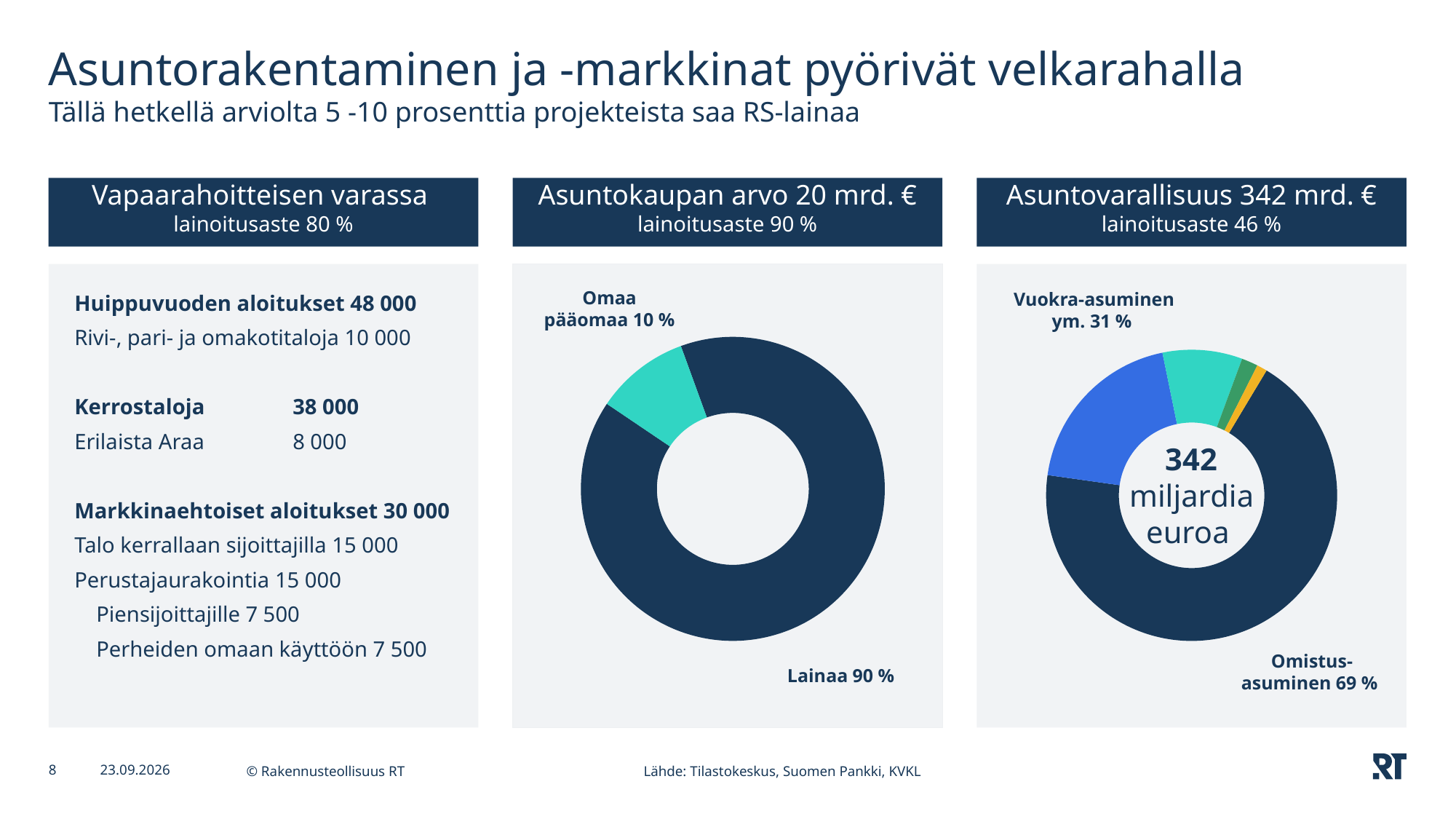
In the chart titled "Asuntokaupan arvo 20 mrd. €", what share is labelled for Omaa pääomaa? 10 % In the chart titled "Asuntovarallisuus 342 mrd. €", what share is labelled for Vuokra-asuminen ym.? 31 % In the chart titled "Asuntokaupan arvo 20 mrd. €", how many labelled categories are there? 2 In the chart titled "Asuntokaupan arvo 20 mrd. €", how many percentage points larger is Lainaa than Omaa pääomaa? 80 percentage points In the chart titled "Asuntovarallisuus 342 mrd. €", which labelled category has the largest share? Omistus-asuminen In the chart titled "Asuntovarallisuus 342 mrd. €", how many percentage points larger is Omistus-asuminen than Vuokra-asuminen ym.? 38 percentage points In the chart titled "Asuntokaupan arvo 20 mrd. €", which is larger, Lainaa or Omaa pääomaa? Lainaa What kind of chart is shown under the heading "Asuntovarallisuus 342 mrd. €"? Donut (pie) chart What kind of chart is shown under the heading "Asuntokaupan arvo 20 mrd. €"? Donut (pie) chart In the chart titled "Asuntovarallisuus 342 mrd. €", what share is labelled for Omistus-asuminen? 69 % What text is printed in the centre of the chart titled "Asuntovarallisuus 342 mrd. €"? 342 miljardia euroa In the chart titled "Asuntokaupan arvo 20 mrd. €", what share is labelled for Lainaa? 90 %